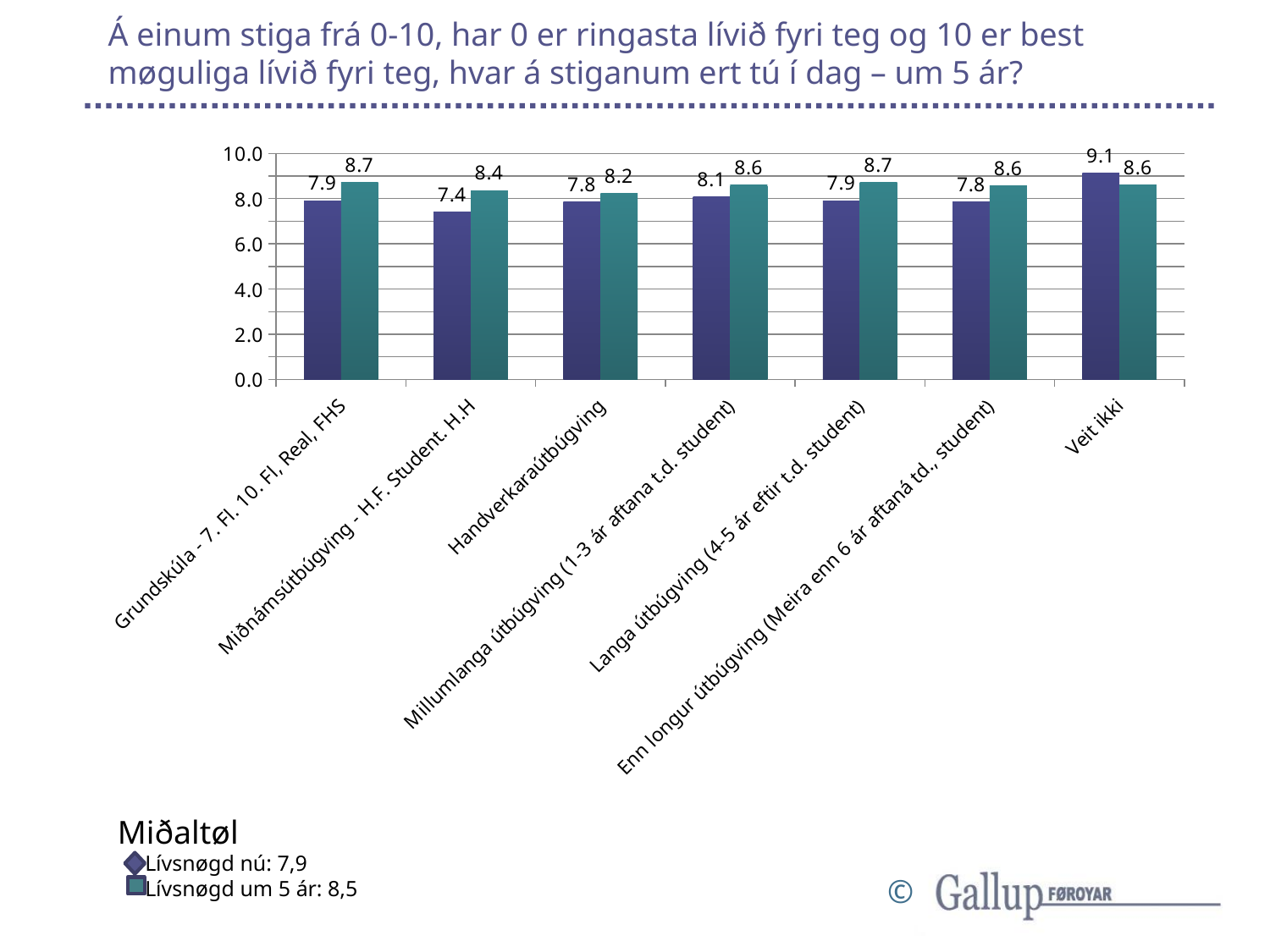
What type of chart is shown on the slide? bar chart What is the difference between 'Lívsnøgd um 5 ár' and 'Lívsnøgd nú' for Miðnámsútbúgving - H.F. Student. H.H? 1.0 What is the value of 'Lívsnøgd nú' for Handverkaraútbúgving? 7.8 According to the legend, what is the overall average (Miðaltøl) for 'Lívsnøgd um 5 ár'? 8,5 What is the value of 'Lívsnøgd um 5 ár' for Miðnámsútbúgving - H.F. Student. H.H? 8.4 Which category has the lowest value for 'Lívsnøgd nú'? Miðnámsútbúgving - H.F. Student. H.H For Veit ikki, which is larger: 'Lívsnøgd nú' or 'Lívsnøgd um 5 ár'? Lívsnøgd nú What is the value of 'Lívsnøgd nú' for Veit ikki? 9.1 How many categories are shown along the x axis of the chart? 7 Which category has the lowest value for 'Lívsnøgd um 5 ár'? Handverkaraútbúgving Which category has the highest value for 'Lívsnøgd nú'? Veit ikki How many series does the chart's legend list? 2